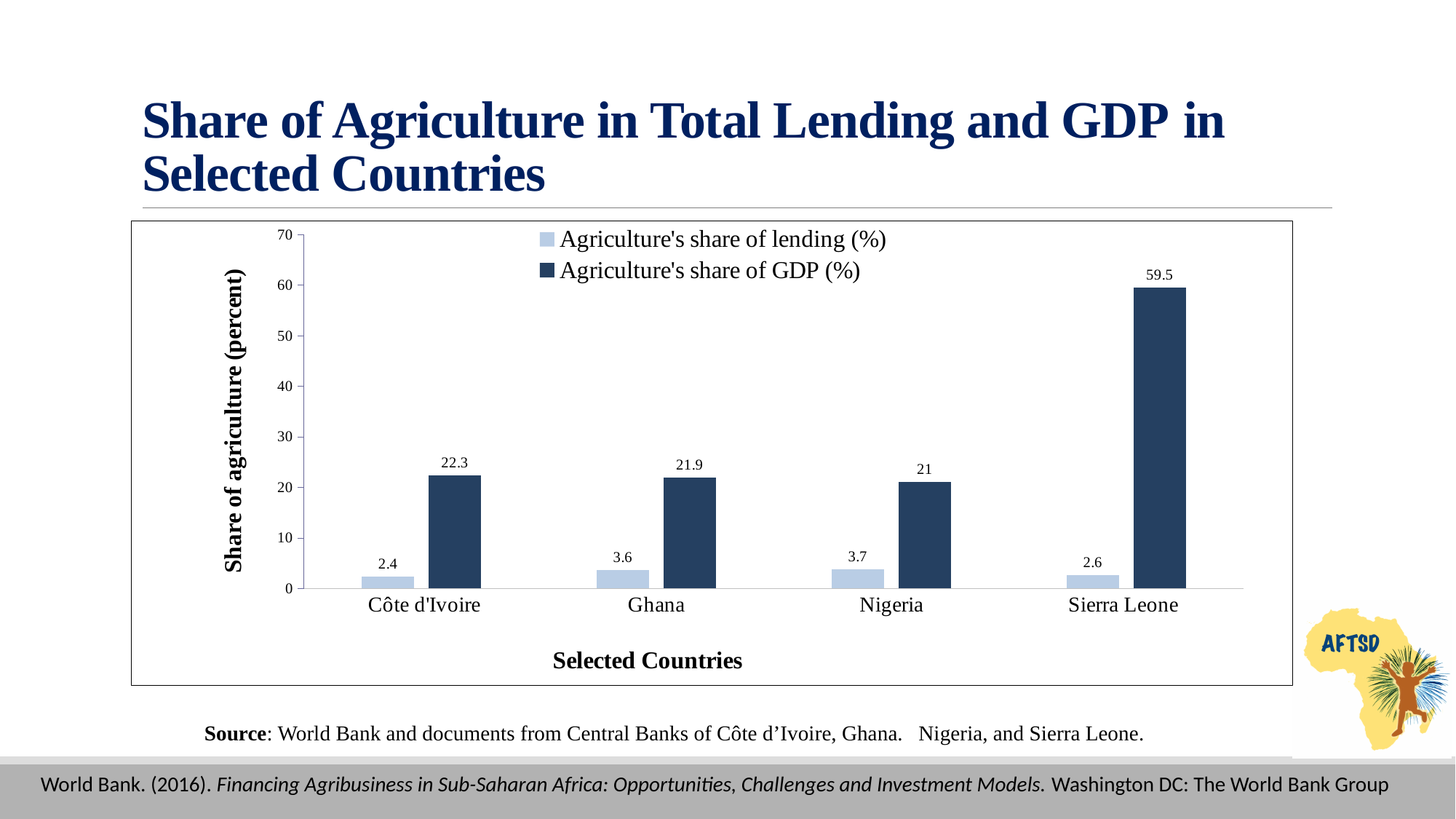
What is the difference between Agriculture's share of GDP (%) and Agriculture's share of lending (%) for Côte d'Ivoire? 19.9 What is Agriculture's share of GDP (%) for Sierra Leone? 59.5 Which country has the lowest Agriculture's share of lending (%)? Côte d'Ivoire What kind of chart is shown on the slide? bar chart Which is larger: Agriculture's share of lending (%) for Nigeria or for Sierra Leone? Nigeria What is Agriculture's share of lending (%) for Ghana? 3.6 How many series does the legend list? 2 Is Agriculture's share of GDP (%) for Sierra Leone greater or less than 50? greater How many countries are shown on the x axis? 4 What is the label of the y axis? Share of agriculture (percent) Which country has the highest Agriculture's share of GDP (%)? Sierra Leone What is Agriculture's share of GDP (%) for Nigeria? 21